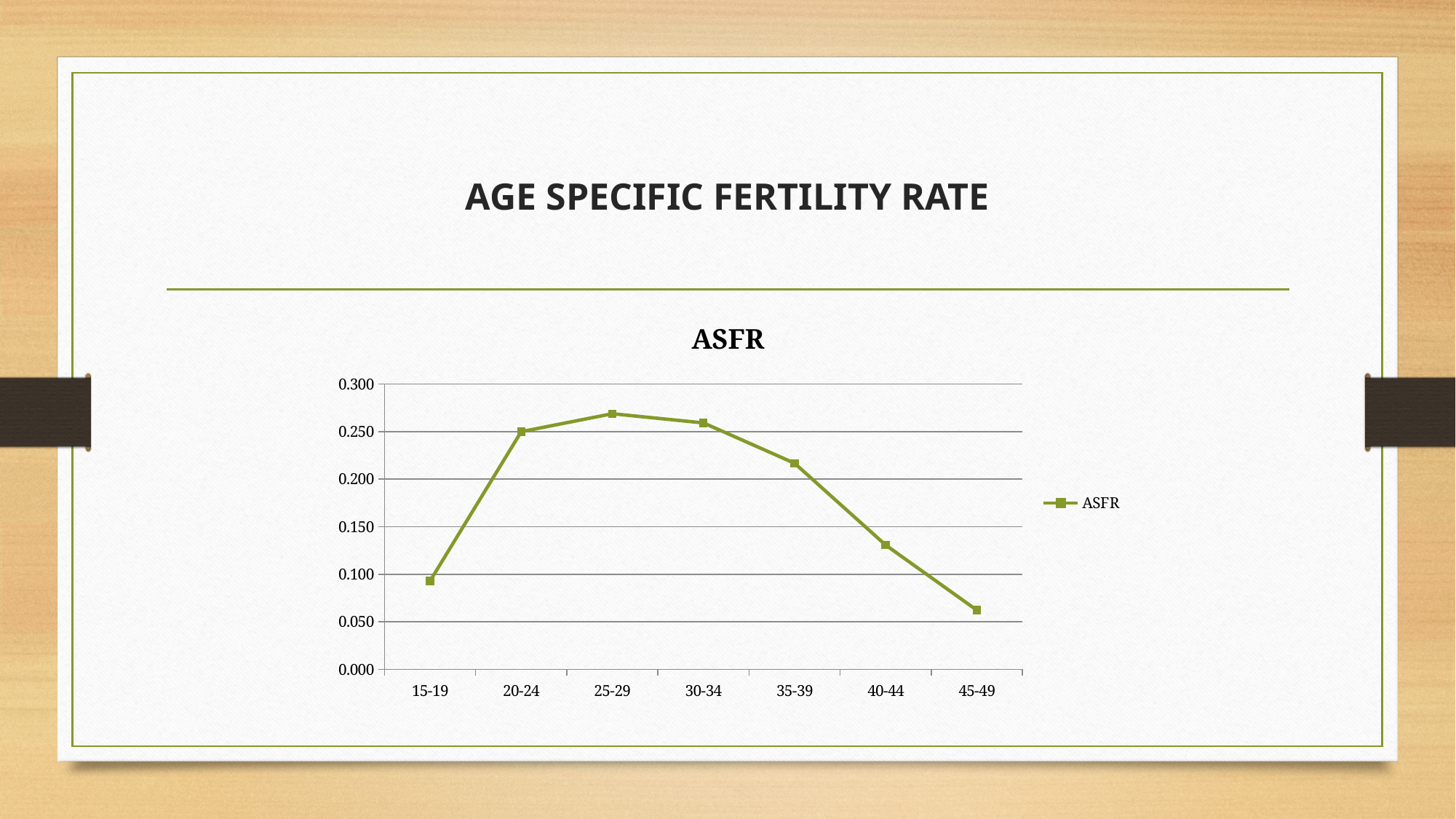
How many series does the legend list? 1 What type of chart is shown on the slide? line chart Is the ASFR value for 45-49 greater or less than 0.050? greater Is the ASFR value for 35-39 greater or less than 0.200? greater Is the ASFR value for 15-19 greater or less than 0.100? less Do the ASFR values rise or fall from 30-34 to 45-49? fall Which age group has the highest ASFR value? 25-29 How many age groups are plotted on the x axis? 7 What is the title of the chart? ASFR Which has a larger ASFR value, 20-24 or 40-44? 20-24 Which age group has the lowest ASFR value? 45-49